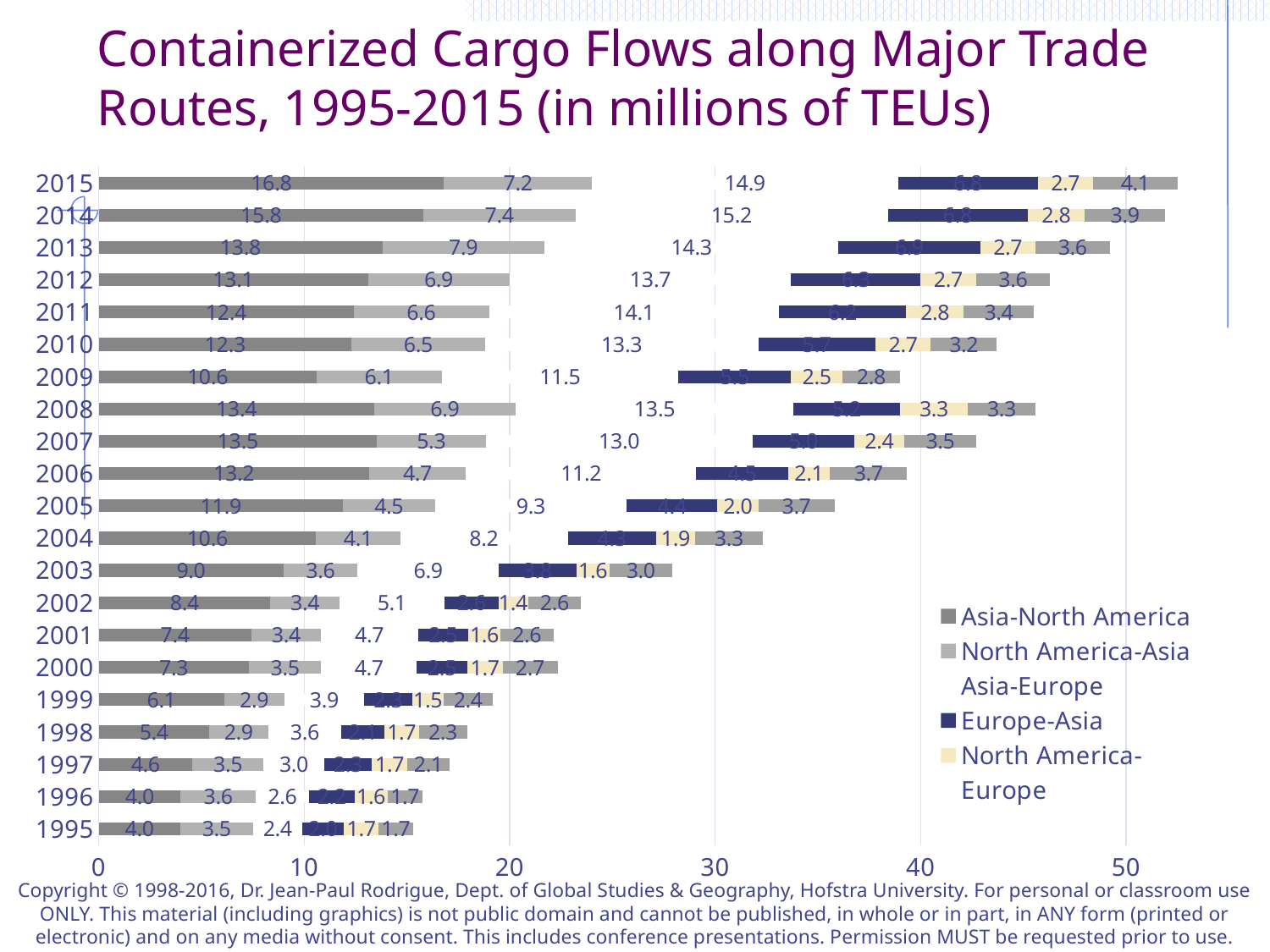
Which year has the larger Asia-Europe value, 2008 or 2009? 2008 What kind of chart is shown on the slide? Stacked bar chart Does the Asia-North America value generally rise or fall from 1995 to 2015? rise What is the Asia-Europe value for 2014? 15.2 What is the difference between the Asia-North America values for 2015 and 2014? 1.0 What is the North America-Asia value for 2013? 7.9 What is the North America-Europe value for 2015? 2.7 Which year has the highest Asia-North America value? 2015 Is the total length of the 2015 bar greater or less than 50? greater How many series does the legend list? 5 How many years are shown on the vertical axis? 21 What is the Asia-North America value for 2015? 16.8